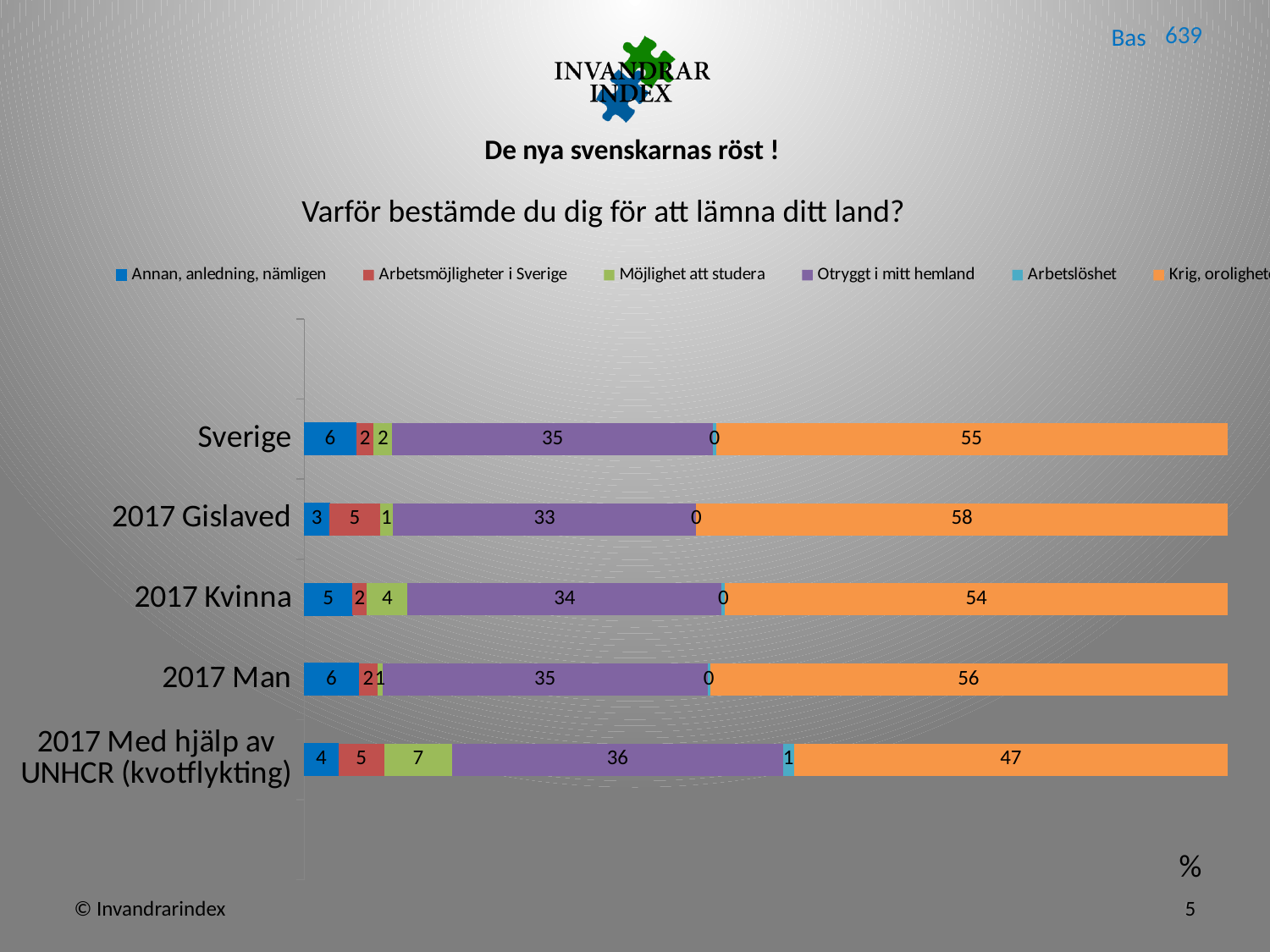
What kind of chart is shown on the slide? Stacked bar chart What is the value for "Otryggt i mitt hemland" for 2017 Med hjälp av UNHCR (kvotflykting)? 36 Which category has the highest value for "Krig, oroligheter"? 2017 Gislaved What is the difference between the "Krig, oroligheter" values for 2017 Gislaved and Sverige? 3 What is the value for "Krig, oroligheter" for 2017 Gislaved? 58 What is the value for "Möjlighet att studera" for 2017 Med hjälp av UNHCR (kvotflykting)? 7 Which has the larger value for "Otryggt i mitt hemland": 2017 Kvinna or 2017 Man? 2017 Man What colour represents "Otryggt i mitt hemland" in the chart? Purple Which category has the lowest value for "Krig, oroligheter"? 2017 Med hjälp av UNHCR (kvotflykting) How many series does the legend list? 6 How many categories are shown on the y axis of the chart? 5 What is the total of the stacked bar for Sverige? 100